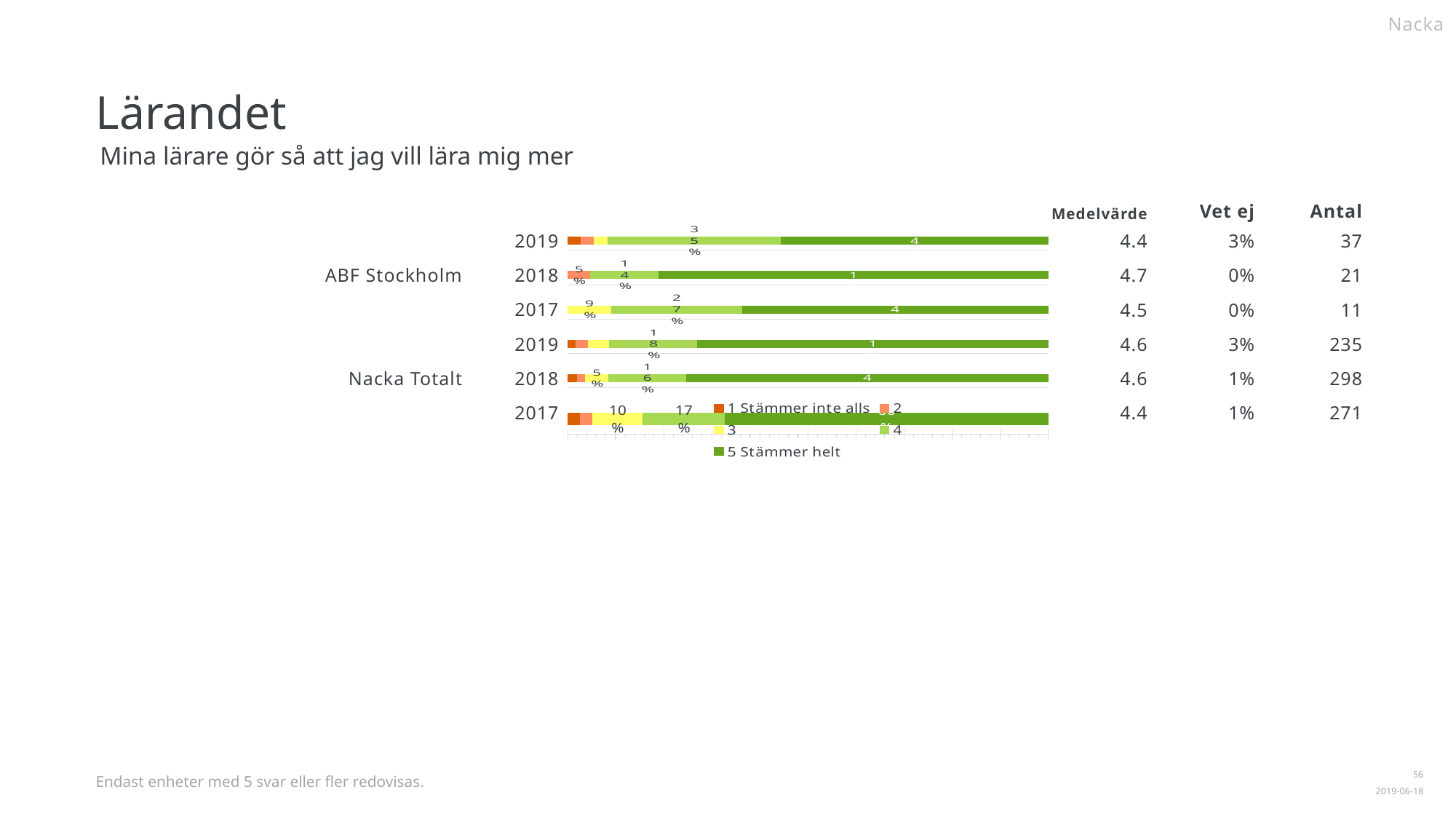
What is the first entry in the chart legend? 1 Stämmer inte alls How many bars are plotted in the chart? 6 What kind of chart is shown on the slide? bar chart How many series does the chart legend list? 5 What is the Medelvärde shown for ABF Stockholm 2018? 4.7 What is the value of the '3' segment for Nacka Totalt 2017? 10% What is the value of the '4' segment for ABF Stockholm 2017? 27% What is the value of the '4' segment for ABF Stockholm 2019? 35% What is the value of the '4' segment for Nacka Totalt 2017? 17% What is the difference between the '4' segment for ABF Stockholm 2019 (35%) and Nacka Totalt 2019 (18%)? 17 percentage points Which has the larger '4' segment: ABF Stockholm 2019 or Nacka Totalt 2019? ABF Stockholm 2019 Which bar has the largest '5 Stämmer helt' segment? ABF Stockholm 2018